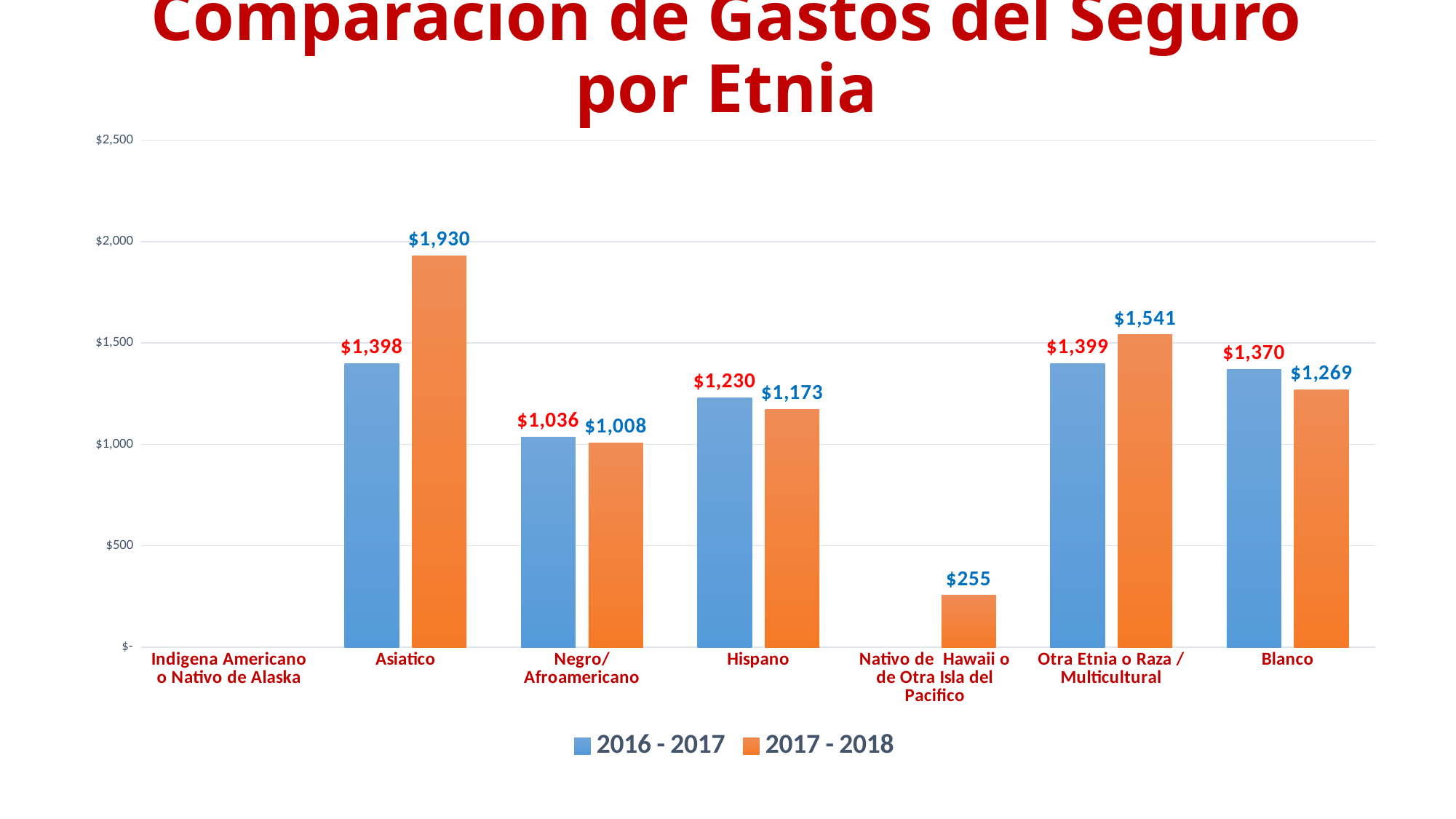
What is the 2016 - 2017 value for Hispano? $1,230 Which is larger for Otra Etnia o Raza / Multicultural: the 2016 - 2017 value or the 2017 - 2018 value? 2017 - 2018 What is the difference between the 2016 - 2017 and 2017 - 2018 values for Blanco? $101 Which category has the lowest 2016 - 2017 value among those with a labeled bar? Negro/ Afroamericano What is the 2017 - 2018 value for Asiatico? $1,930 What is the 2017 - 2018 value for Nativo de Hawaii o de Otra Isla del Pacifico? $255 Which category has the highest 2017 - 2018 value? Asiatico How many series does the legend list? 2 Is the 2017 - 2018 value for Nativo de Hawaii o de Otra Isla del Pacifico greater or less than $500? less How many categories are shown on the x axis? 7 What is the difference between the 2017 - 2018 and 2016 - 2017 values for Asiatico? $532 What kind of chart is shown on the slide? bar chart